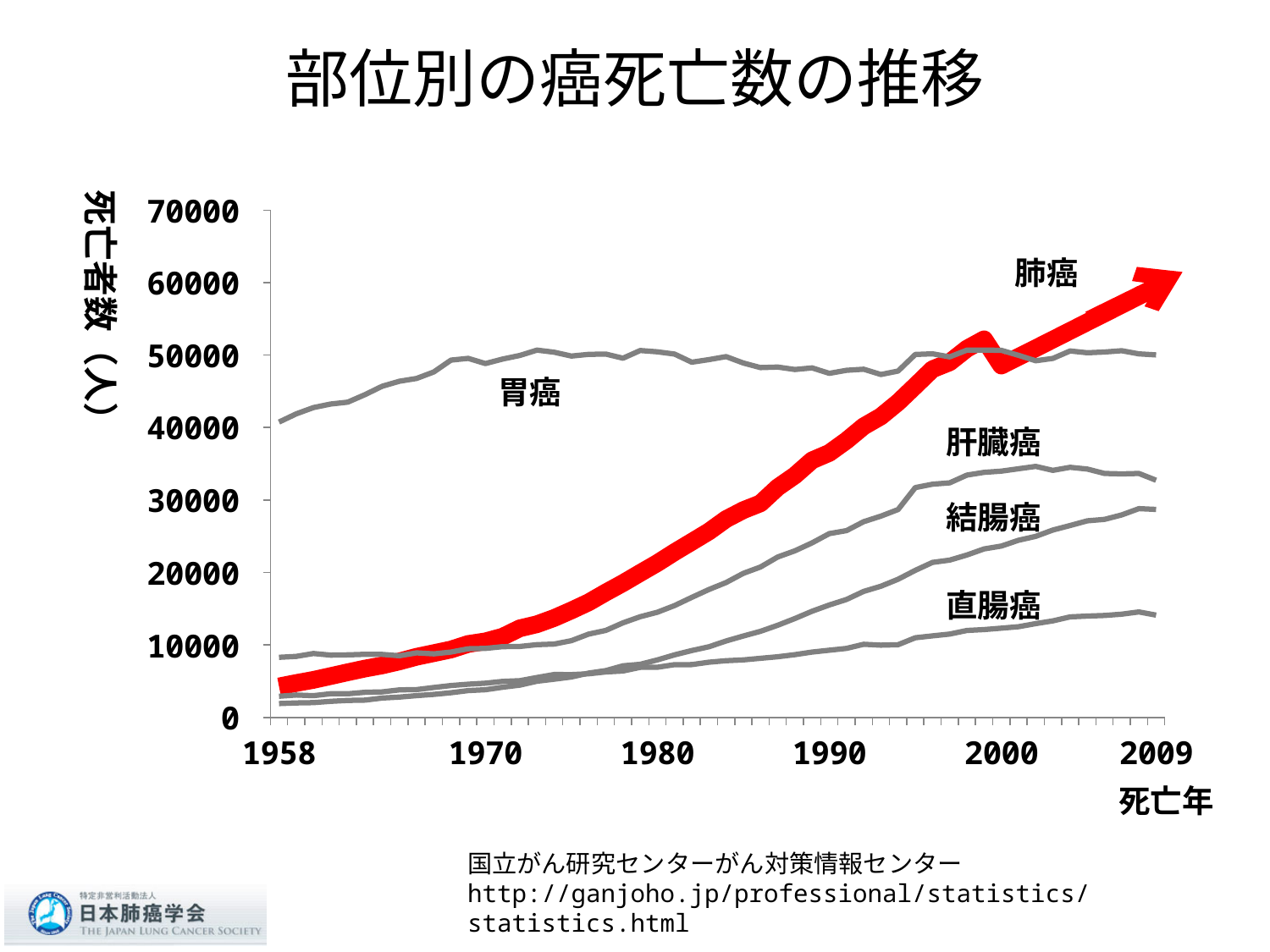
Is the value for 肝臓癌 in 2009 greater or less than 30000? greater Which cancer type has the highest number of deaths in 1958? 胃癌 In 2009, which has more deaths, 肝臓癌 or 直腸癌? 肝臓癌 Is the value for 直腸癌 in 2009 greater or less than 20000? less Which cancer type has the highest number of deaths in 2009? 肺癌 Which cancer type has the lowest number of deaths in 2009? 直腸癌 Which line on the chart is drawn in red? 肺癌 How many cancer types (lines) are plotted on the chart? 5 What is the title of the chart on the slide? 部位別の癌死亡数の推移 Does the number of deaths from 肺癌 rise or fall from 1958 to 2009? rise Is the value for 肺癌 in 1958 greater or less than 10000? less What kind of chart is shown on the slide? line chart